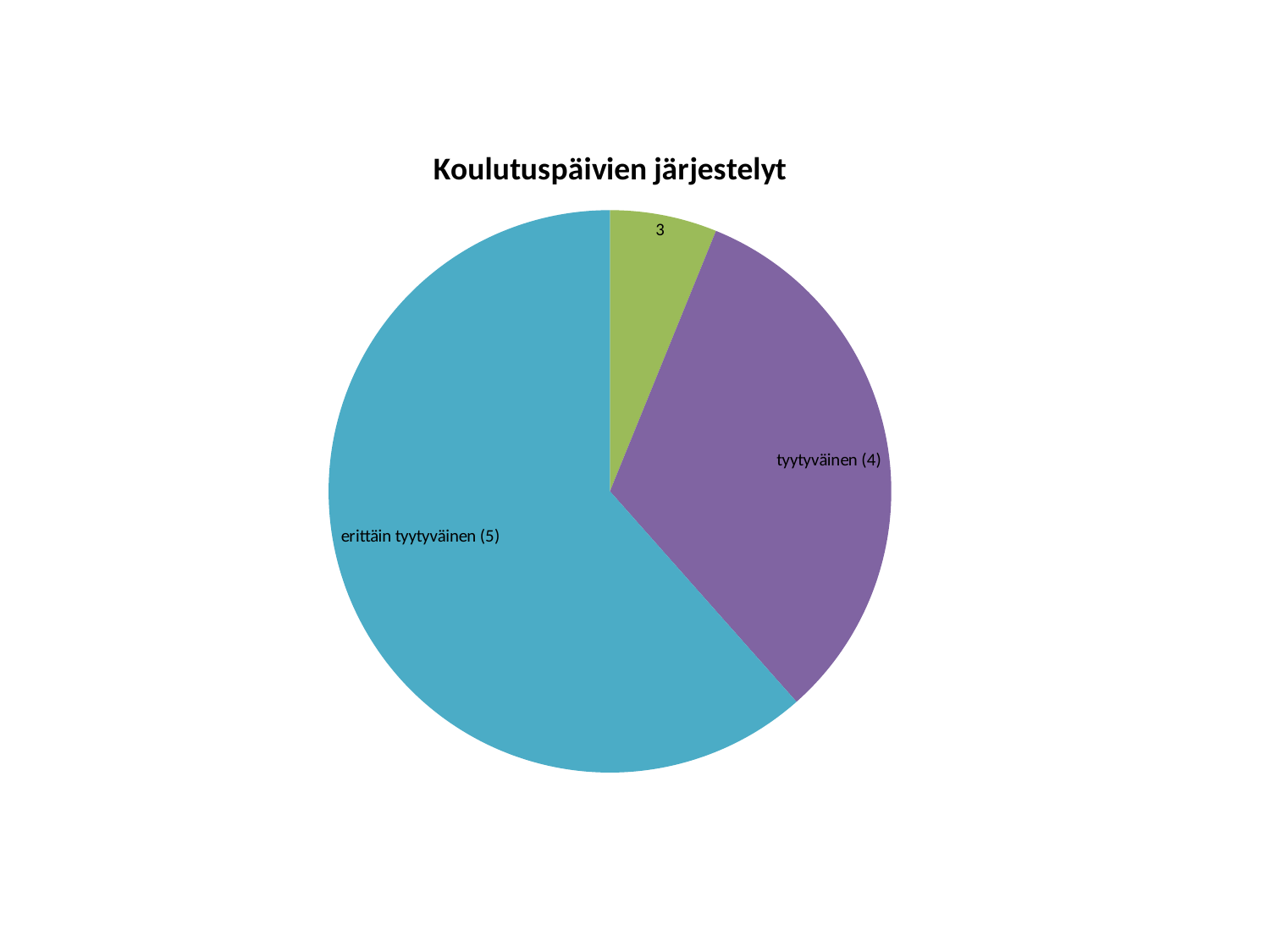
What kind of chart is shown on the slide? pie chart Does the "erittäin tyytyväinen (5)" slice take up more or less than half of the pie? more How many slices does the pie chart have? 3 What is the title of the chart? Koulutuspäivien järjestelyt Which slice is the smallest in the pie chart? 3 Which slice is the largest in the pie chart? erittäin tyytyväinen (5) Which slice is larger, "tyytyväinen (4)" or "3"? tyytyväinen (4) What colour is the "erittäin tyytyväinen (5)" slice? blue Which slice is larger, "erittäin tyytyväinen (5)" or "tyytyväinen (4)"? erittäin tyytyväinen (5)